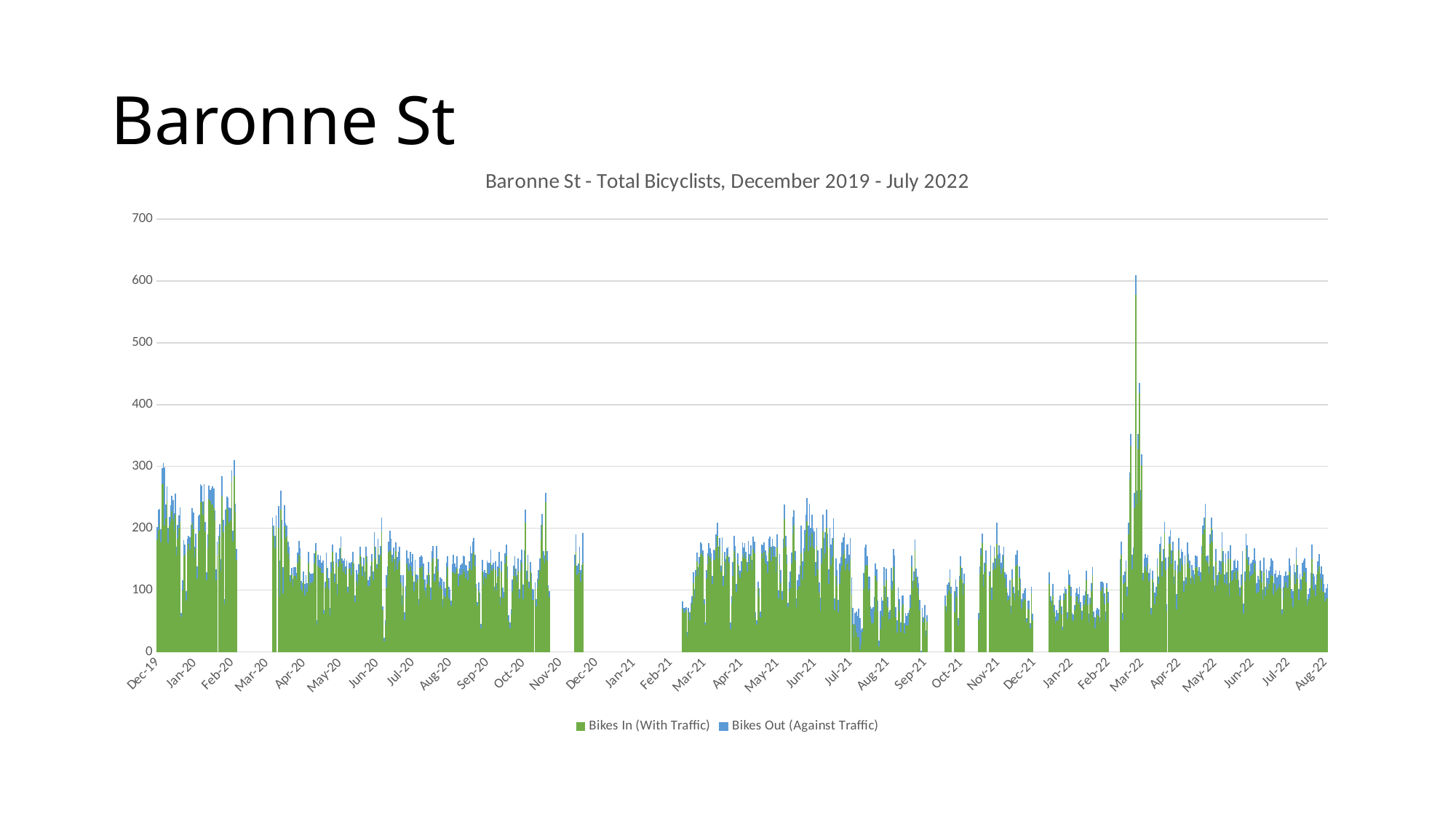
What is the title of the chart? Baronne St - Total Bicyclists, December 2019 - July 2022 What kind of chart is shown on the slide? Bar chart Are the bars around Jan-22 greater or less than 200? less Near which month label does the tallest bar in the chart occur? Mar-22 What are the two series named in the legend? Bikes In (With Traffic) and Bikes Out (Against Traffic) How many month labels are shown on the horizontal axis? 33 What is the last month label on the horizontal axis? Aug-22 What is the highest value shown on the vertical axis? 700 Which month label in early 2021 has no bars plotted at all? Jan-21 What is the first month label on the horizontal axis? Dec-19 How many series does the legend list? 2 Is the tallest bar in the chart greater or less than 500? greater